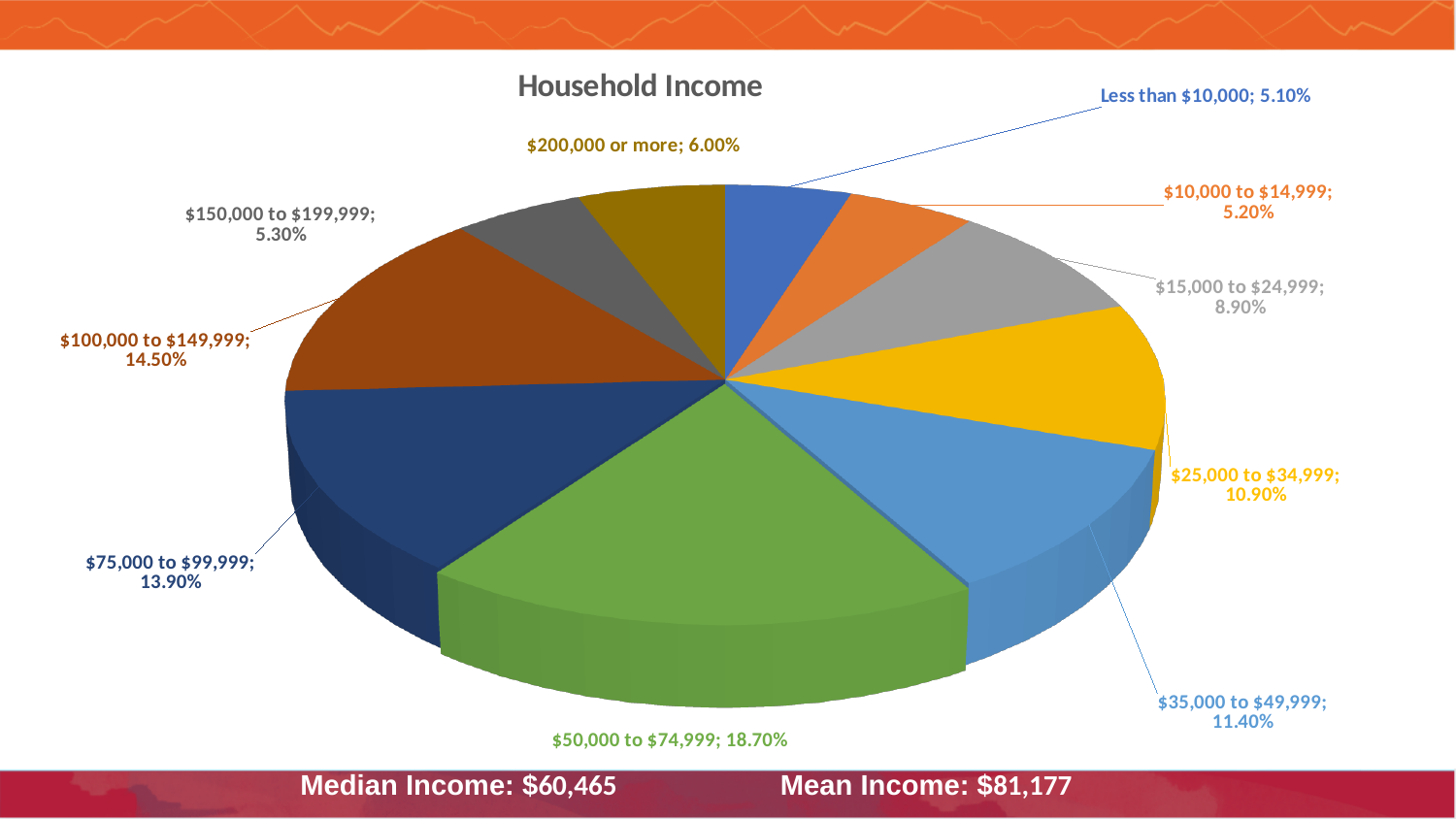
Which income category has the largest share of the pie? $50,000 to $74,999 Which is larger: the share for $75,000 to $99,999 or the share for $100,000 to $149,999? $100,000 to $149,999 What is the value shown for $100,000 to $149,999? 14.50% What is the title of the chart? Household Income What share of the pie is the $50,000 to $74,999 slice? 18.70% What is the value shown for $35,000 to $49,999? 11.40% What is the difference in percentage points between the $50,000 to $74,999 slice and the $100,000 to $149,999 slice? 4.20 Which income category has the smallest share of the pie? Less than $10,000 What is the value shown for $200,000 or more? 6.00% What kind of chart is shown on the slide? pie chart How many slices does the Household Income pie chart have? 10 What is the value shown for $15,000 to $24,999? 8.90%